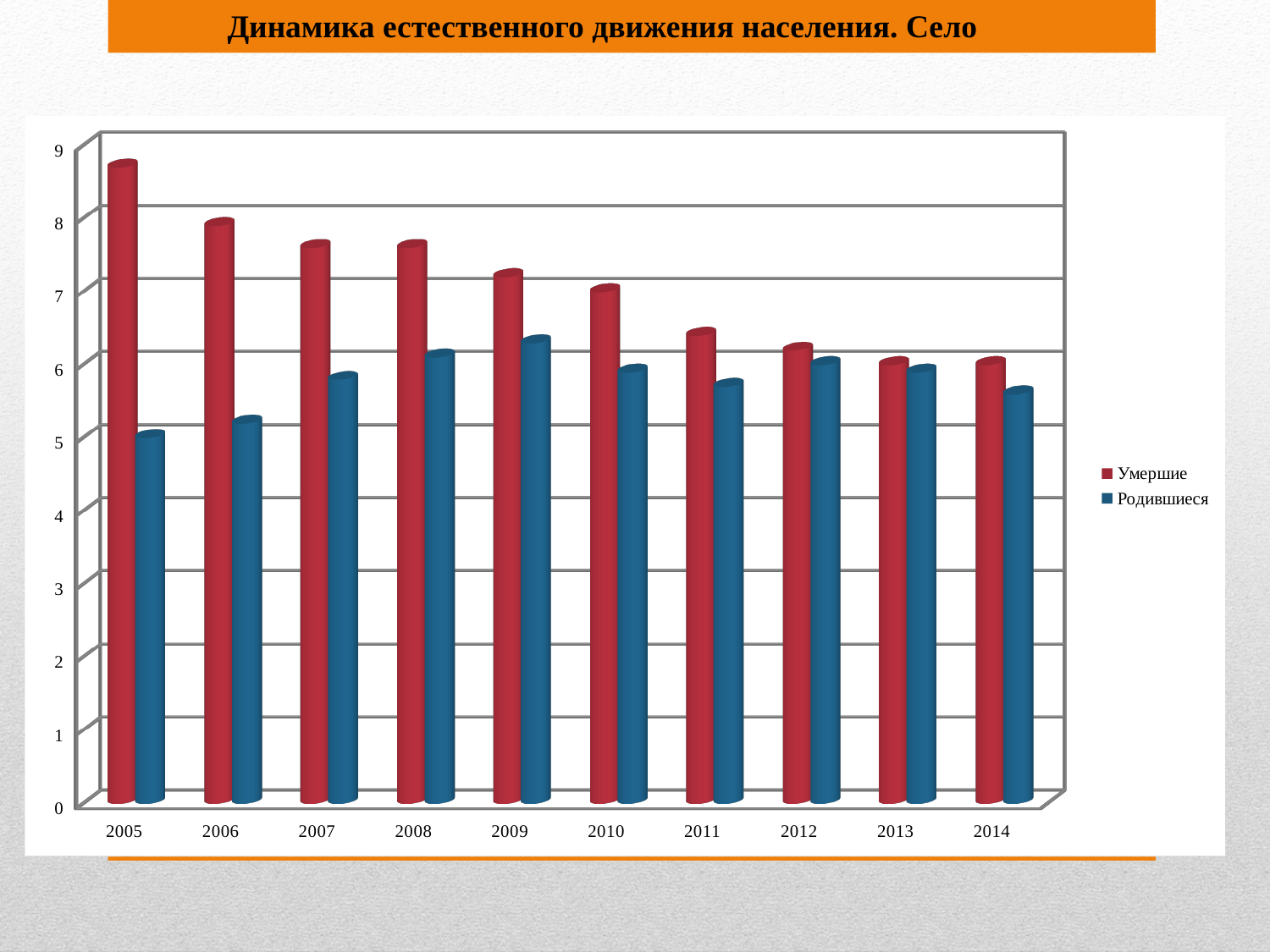
Is the value for Родившиеся in 2014 greater or less than 6? less How many years are shown on the x axis? 10 What kind of chart is shown on the slide? bar chart Is the value for Умершие in 2011 greater or less than 7? less Do the values for Умершие rise or fall from 2005 to 2014? fall How many series does the legend list? 2 In 2009, which is larger: Умершие or Родившиеся? Умершие Is the value for Умершие in 2005 greater or less than 8? greater What is the title of the slide? Динамика естественного движения населения. Село Which year has the highest value for Умершие? 2005 In 2005, which is larger: Умершие or Родившиеся? Умершие